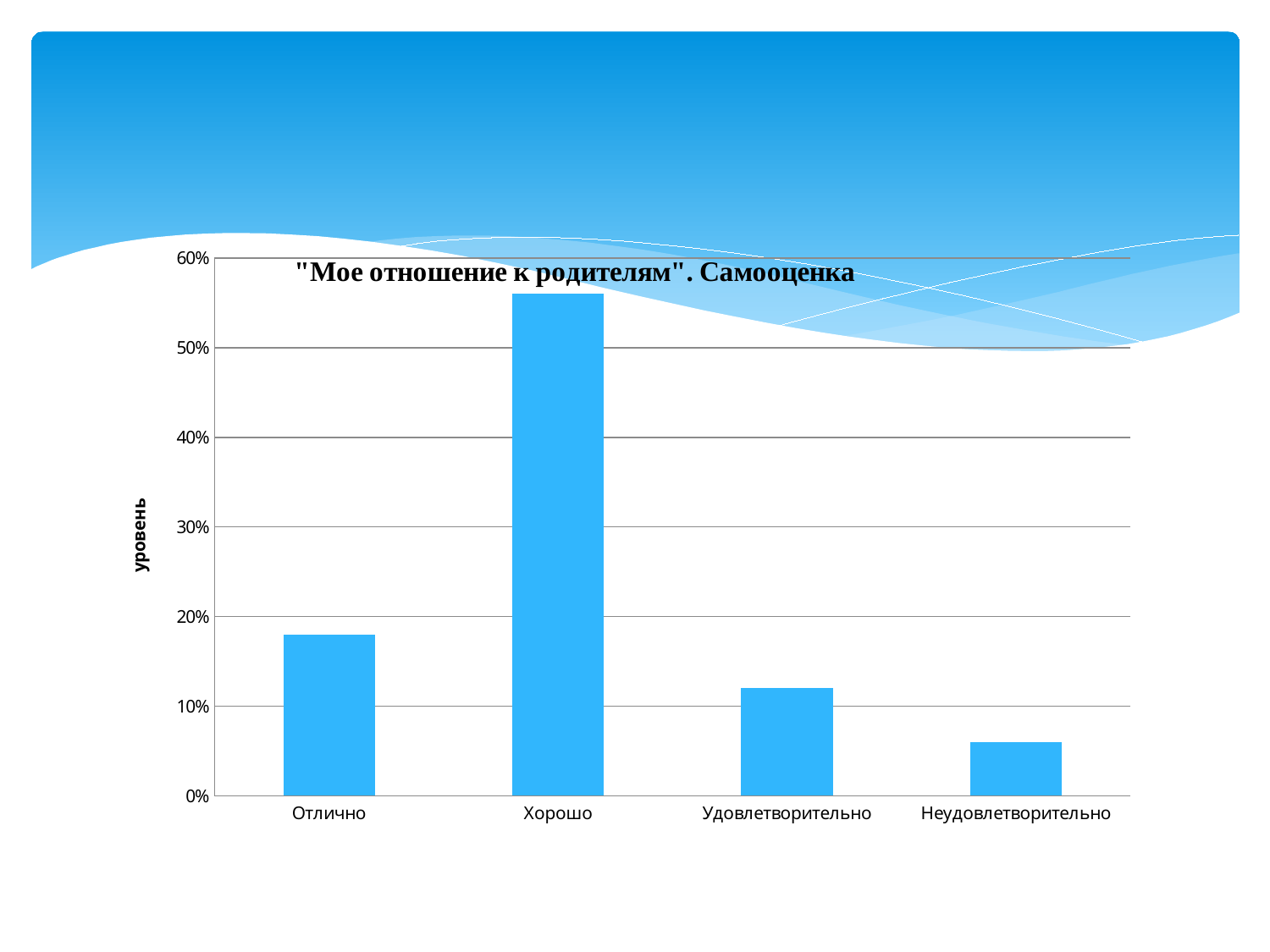
Is the value for Отлично greater or less than 20%? less What is the title of the chart? "Мое отношение к родителям". Самооценка What kind of chart is shown on the slide? bar chart Which is larger, the value for Удовлетворительно or the value for Неудовлетворительно? Удовлетворительно Is the value for Отлично greater or less than 10%? greater Which category has the highest value? Хорошо How many categories are shown on the x axis? 4 Which is larger, the value for Отлично or the value for Удовлетворительно? Отлично Which category has the lowest value? Неудовлетворительно Is the value for Хорошо greater or less than 50%? greater What is the label of the vertical axis? уровень